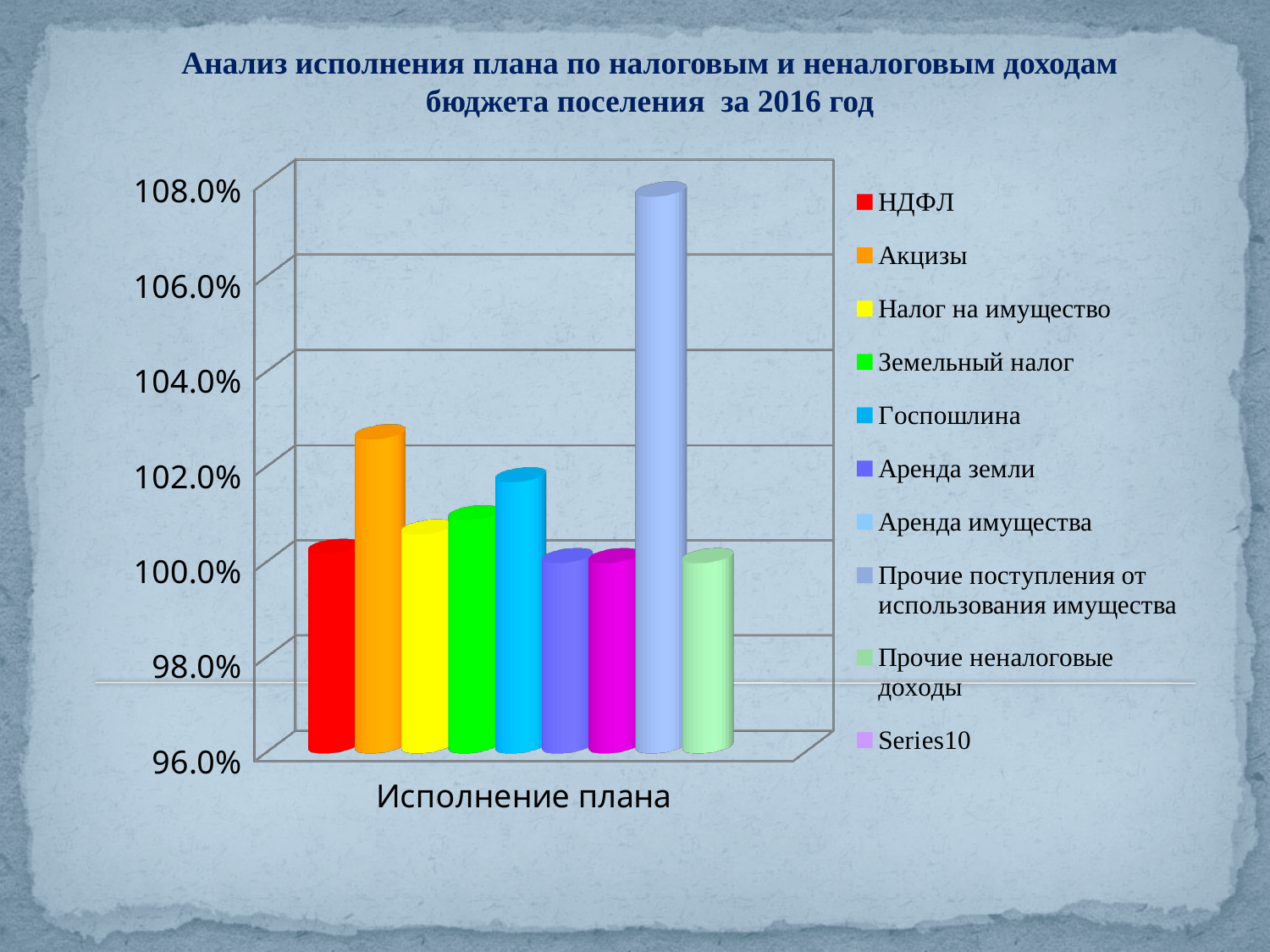
What kind of chart is shown on the slide? bar chart What is the category label shown on the x axis? Исполнение плана Which series has the highest bar? Прочие поступления от использования имущества Is the value for НДФЛ greater or less than 102.0%? less Which is larger, the value for Госпошлина or the value for Налог на имущество? Госпошлина Is the value for Прочие поступления от использования имущества greater or less than 106.0%? greater What colour is the bar for НДФЛ? red Is the value for Аренда земли greater or less than 102.0%? less Which is larger, the value for Акцизы or the value for НДФЛ? Акцизы How many series does the legend list? 10